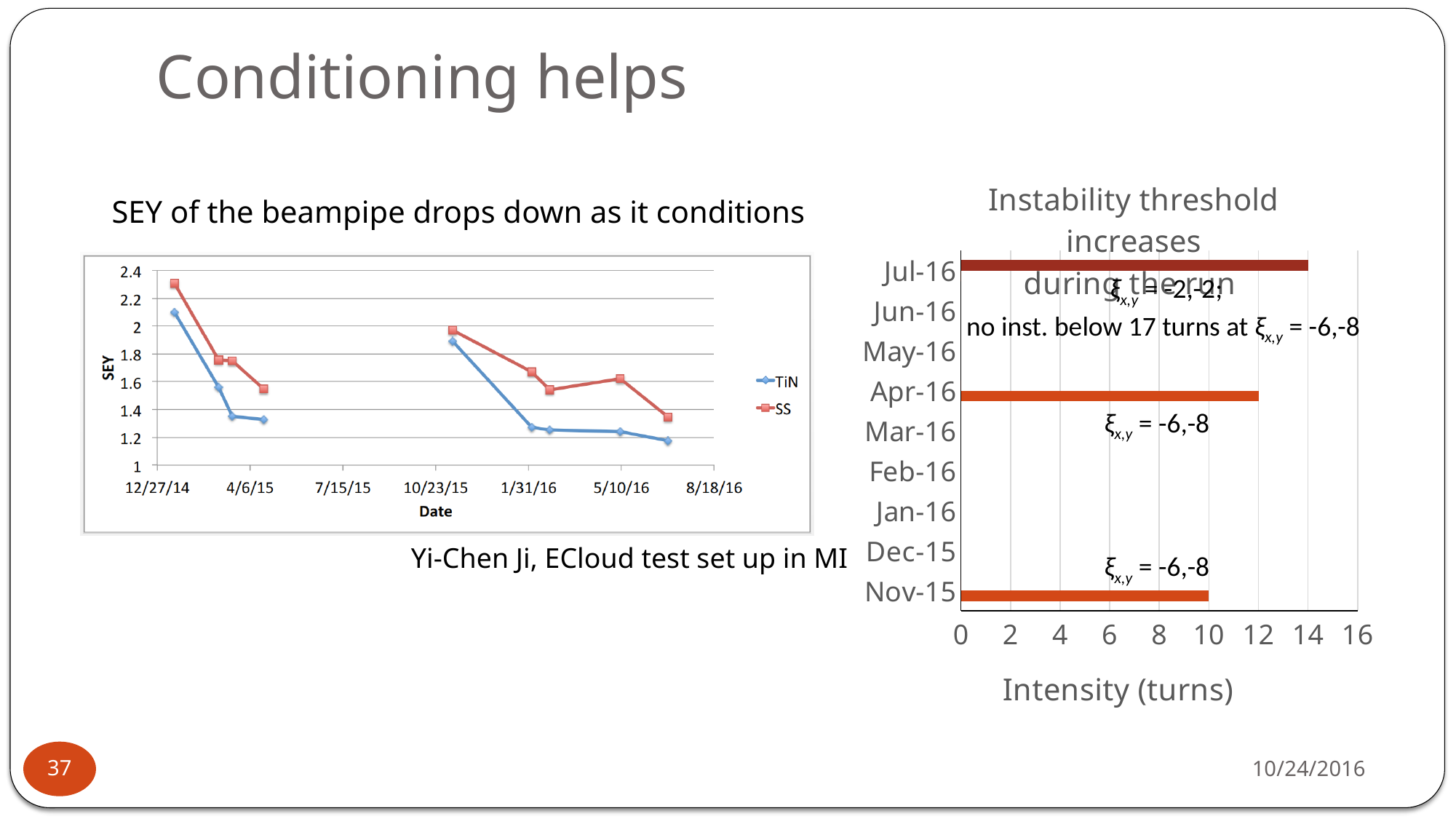
In the right 'Instability threshold' chart, which month has the highest intensity (turns)? Jul-16 In the right 'Instability threshold' chart, what is the intensity (turns) for Apr-16? 12 In the left SEY chart, which series has the higher SEY at the first measurement date, TiN or SS? SS In the right 'Instability threshold' chart, how many bars are plotted? 3 In the left SEY chart, is the first SS value (at 12/27/14) greater or less than 2.2? greater What kind of chart is the right chart titled 'Instability threshold increases during the run'? bar chart In the right 'Instability threshold' chart, what is the difference in intensity (turns) between Jul-16 and Nov-15? 4 In the right 'Instability threshold' chart, what is the intensity (turns) for Nov-15? 10 How many series does the legend of the left SEY chart list? 2 What kind of chart is the left chart showing SEY versus Date? line chart In the left SEY chart, do the SEY values for TiN generally rise or fall over time? fall